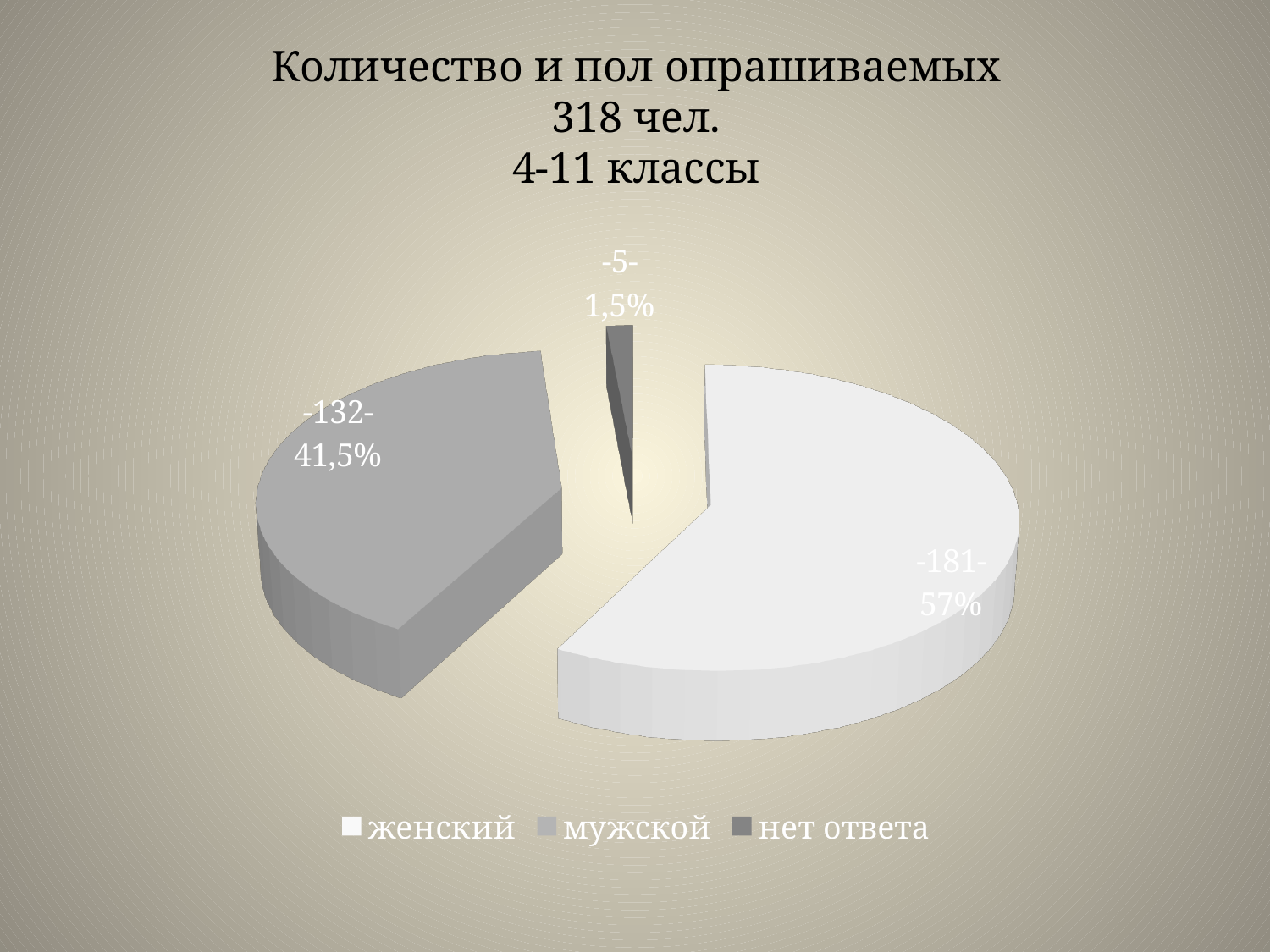
What share of the pie does the женский slice represent? 57% What is the count shown for the нет ответа slice? 5 Which slice is the smallest? нет ответа What is the difference between the counts for женский and мужской? 49 How many slices does the pie chart have? 3 What is the count shown for the мужской slice? 132 What share of the pie does the мужской slice represent? 41,5% What share of the pie does the нет ответа slice represent? 1,5% How many entries does the legend list? 3 Which slice is the largest? женский What kind of chart is shown on the slide? pie chart What is the count shown for the женский slice? 181